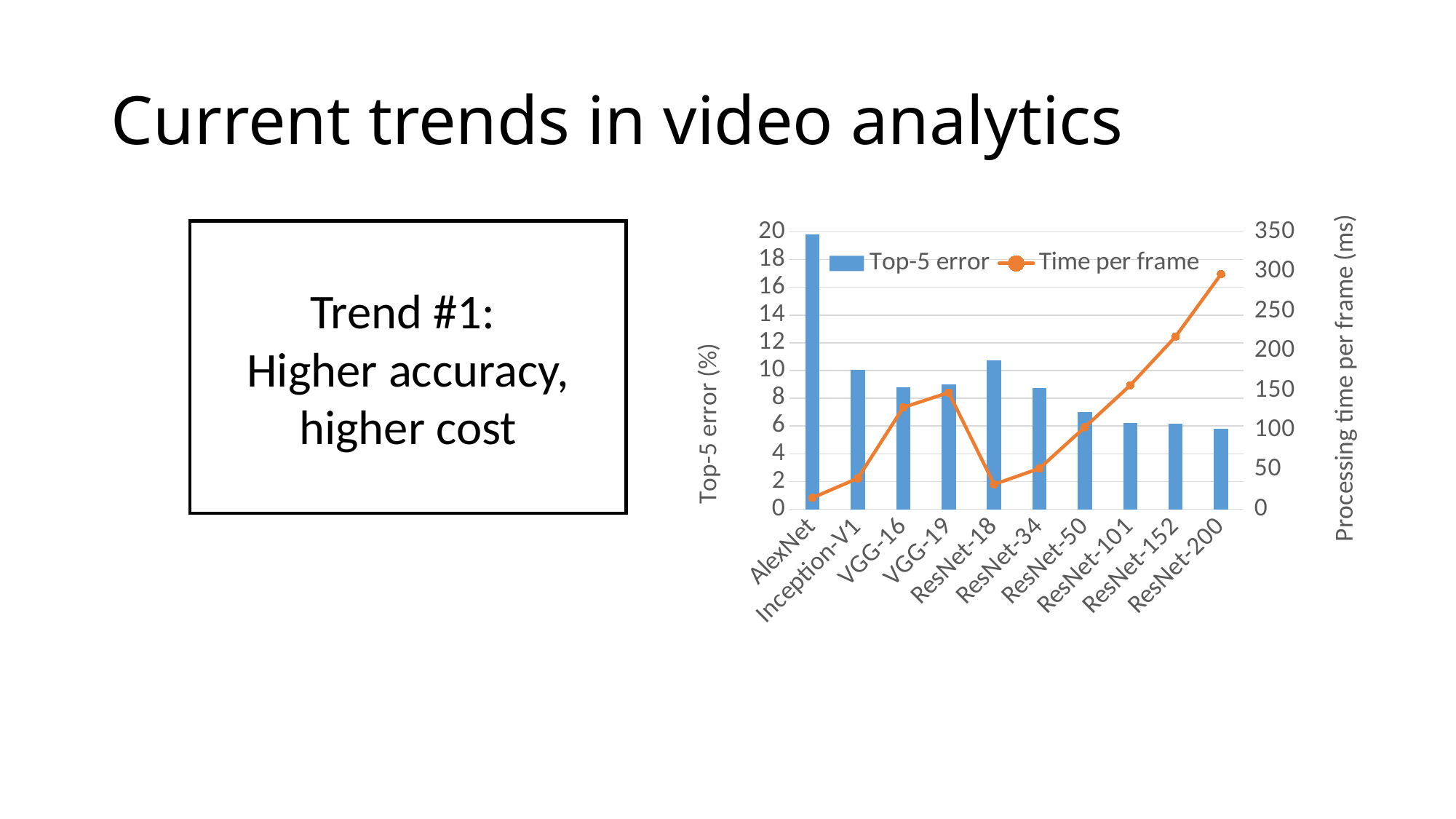
How many models are shown along the x axis of the chart? 10 Which model has the highest Top-5 error? AlexNet Which model has the highest time per frame? ResNet-200 Which has the higher Top-5 error, Inception-V1 or ResNet-18? ResNet-18 How many series does the chart legend list? 2 Which model has the lowest time per frame? AlexNet Is the time per frame for ResNet-18 greater or less than 50? less Is the Top-5 error for AlexNet greater or less than 18? greater What kind of chart is shown on the slide? Combination bar and line chart What is the label of the right-hand vertical axis? Processing time per frame (ms) Is the time per frame for ResNet-200 greater or less than 250? greater Does the time per frame rise or fall from ResNet-18 to ResNet-200? rises